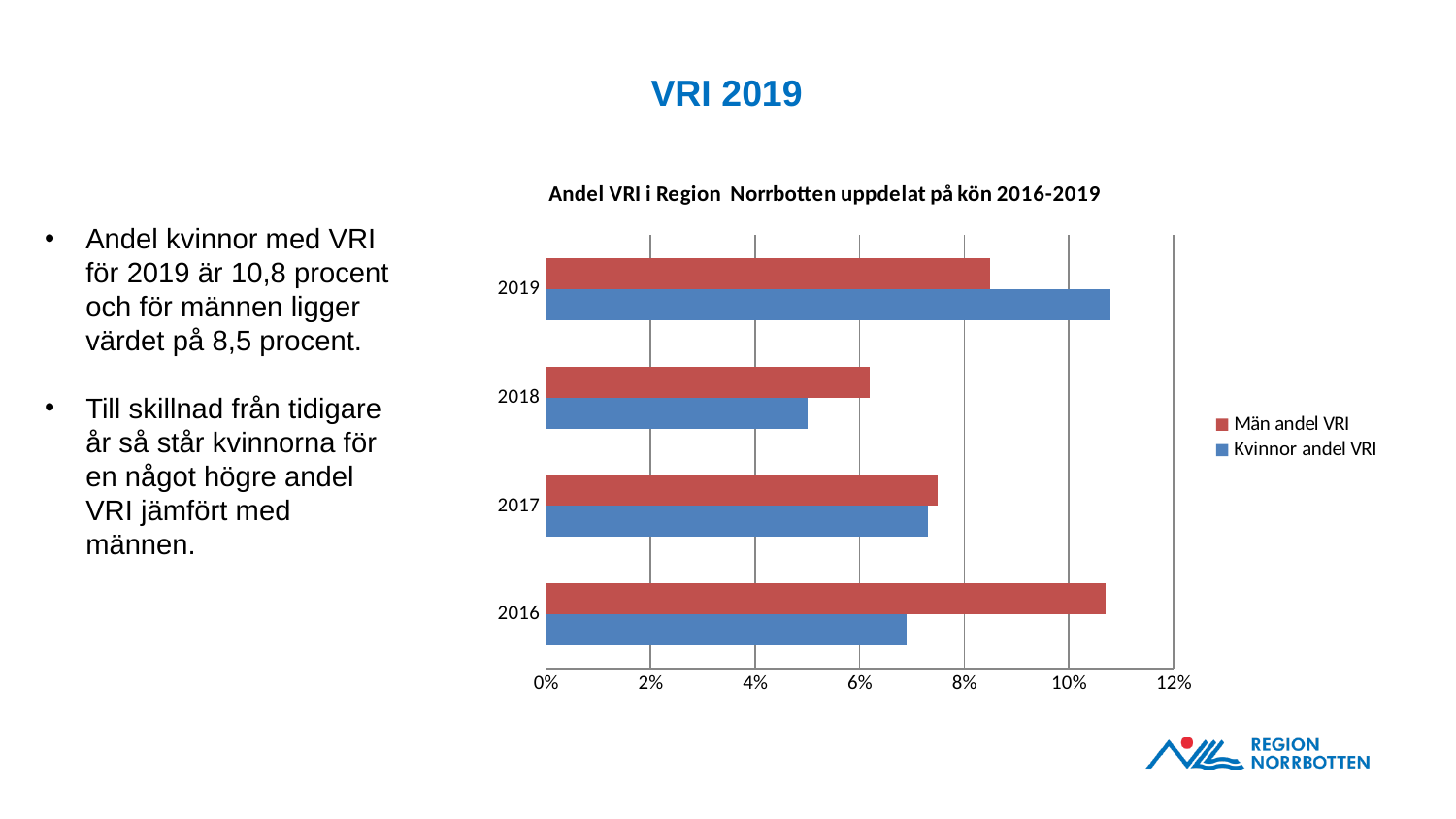
Is the value for 'Kvinnor andel VRI' in 2018 greater or less than 6%? less In 2019, which series has the larger value, 'Män andel VRI' or 'Kvinnor andel VRI'? Kvinnor andel VRI In which year is the value for 'Kvinnor andel VRI' highest? 2019 Which colour represents 'Kvinnor andel VRI' in the chart? blue In which year is the value for 'Män andel VRI' lowest? 2018 In which year is the value for 'Män andel VRI' highest? 2016 In 2016, which series has the larger value, 'Män andel VRI' or 'Kvinnor andel VRI'? Män andel VRI How many series does the chart legend list? 2 In which year is the value for 'Kvinnor andel VRI' lowest? 2018 What is the title of the chart? Andel VRI i Region Norrbotten uppdelat på kön 2016-2019 How many years are shown on the chart's vertical axis? 4 What kind of chart is shown on the slide? bar chart